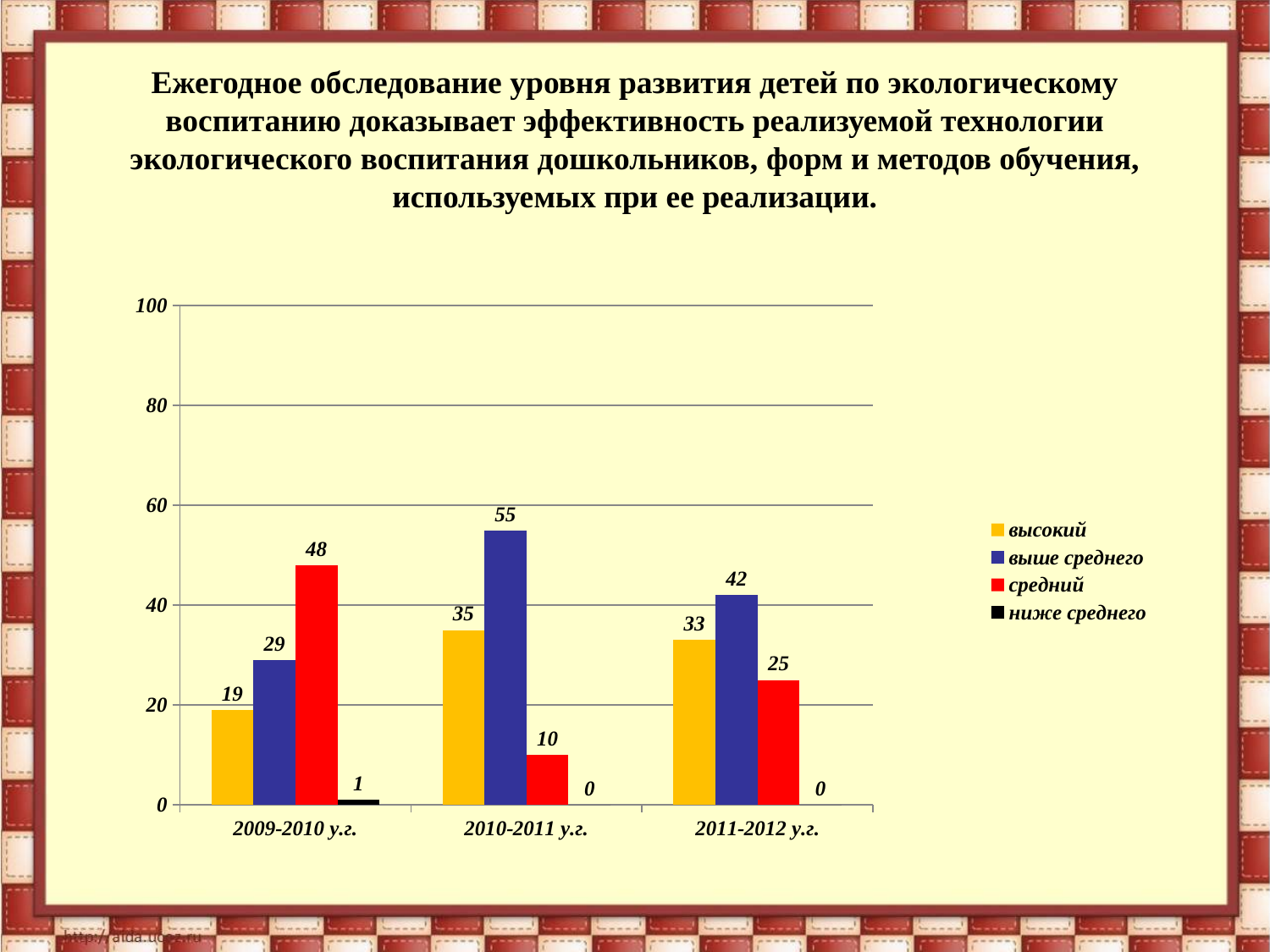
Which is larger in 2011-2012 у.г.: "высокий" or "выше среднего"? выше среднего What is the difference between the "выше среднего" values in 2010-2011 у.г. and 2009-2010 у.г.? 26 What is the value for "ниже среднего" in 2009-2010 у.г.? 1 What is the value for "высокий" in 2009-2010 у.г.? 19 How many year categories are shown on the x axis? 3 In which year is the value for "высокий" the lowest? 2009-2010 у.г. What kind of chart is shown on the slide? bar chart Is the value for "средний" in 2009-2010 у.г. greater or less than 40? greater What is the value for "средний" in 2011-2012 у.г.? 25 In which year is the value for "средний" the highest? 2009-2010 у.г. How many series does the legend list? 4 What is the value for "выше среднего" in 2010-2011 у.г.? 55